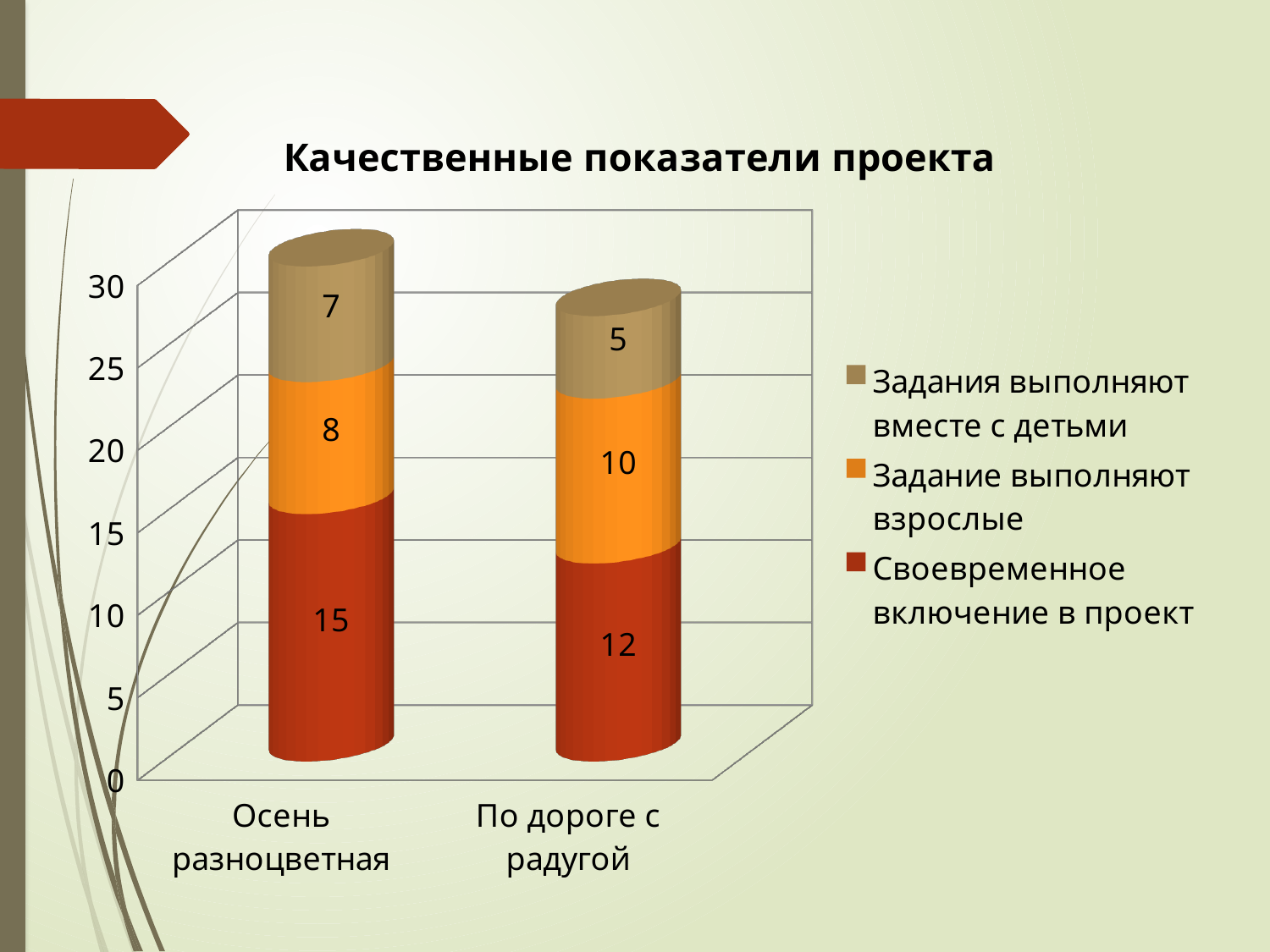
What is the total of the stacked bar for "Осень разноцветная"? 30 Which category has the larger value for "Задание выполняют взрослые": "Осень разноцветная" or "По дороге с радугой"? По дороге с радугой What is the value of "Своевременное включение в проект" for "Осень разноцветная"? 15 What is the value of "Задания выполняют вместе с детьми" for "Осень разноцветная"? 7 What is the difference between the "Своевременное включение в проект" values for "Осень разноцветная" and "По дороге с радугой"? 3 How many categories are shown on the x axis? 2 How many series does the legend list? 3 What is the value of "Своевременное включение в проект" for "По дороге с радугой"? 12 What is the value of "Задание выполняют взрослые" for "По дороге с радугой"? 10 Which category has the lower value for "Задания выполняют вместе с детьми"? По дороге с радугой What is the total of the stacked bar for "По дороге с радугой"? 27 What is the title of the chart? Качественные показатели проекта